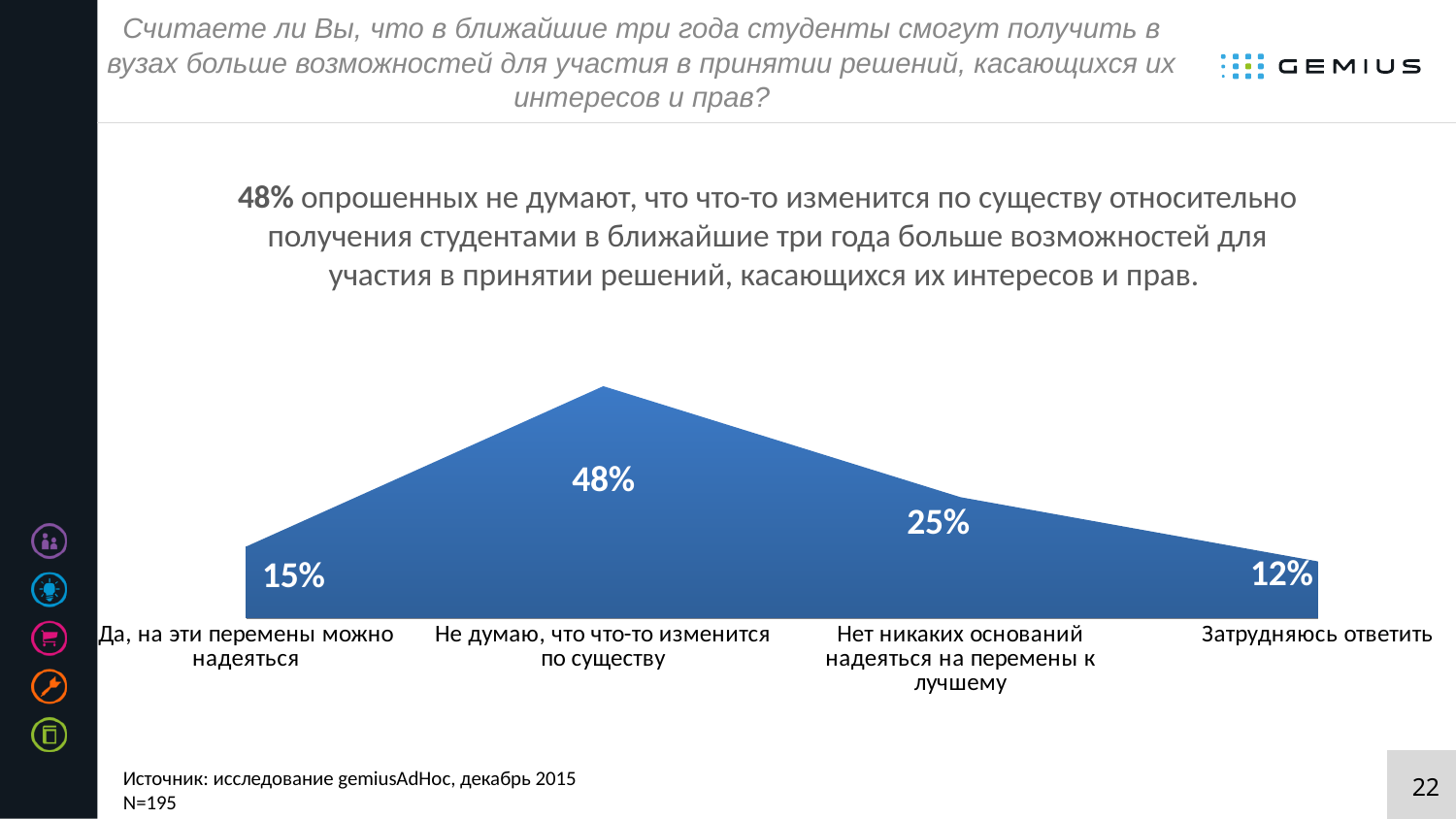
What kind of chart is shown on the slide? Area chart Which answer option has the lowest value? Затрудняюсь ответить What is the value for "Да, на эти перемены можно надеяться"? 15% What is the difference between the values for "Не думаю, что что-то изменится по существу" and "Нет никаких оснований надеяться на перемены к лучшему"? 23% What is the value for "Нет никаких оснований надеяться на перемены к лучшему"? 25% What is the difference between the values for "Да, на эти перемены можно надеяться" and "Затрудняюсь ответить"? 3% What percentage of respondents chose "Не думаю, что что-то изменится по существу"? 48% How many answer categories are shown in the chart? 4 Which is larger: the value for "Нет никаких оснований надеяться на перемены к лучшему" or the value for "Да, на эти перемены можно надеяться"? Нет никаких оснований надеяться на перемены к лучшему Which answer option has the highest value? Не думаю, что что-то изменится по существу What share of respondents answered "Затрудняюсь ответить"? 12% What is the sample size (N) stated on the slide? N=195